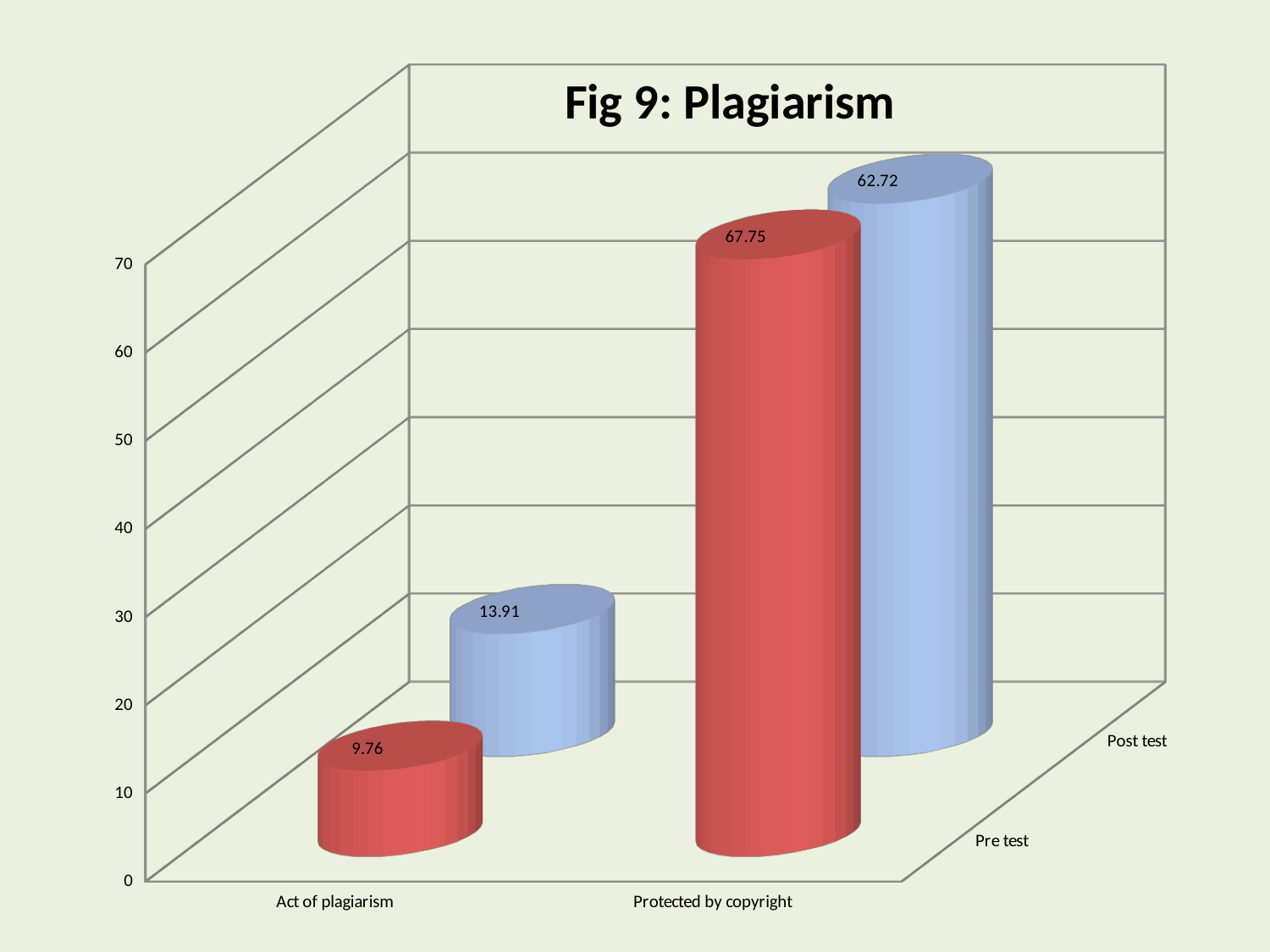
For Act of plagiarism, which is larger: the Pre test or the Post test value? Post test Which bar has the highest value on the chart? Protected by copyright, Pre test How many series (Pre test and Post test) are plotted on the chart? 2 What is the Pre test value for Protected by copyright? 67.75 What is the title of the chart? Fig 9: Plagiarism What is the difference between the Post test and Pre test values for Act of plagiarism? 4.15 What is the Pre test value for Act of plagiarism? 9.76 What is the Post test value for Act of plagiarism? 13.91 What is the difference between the Pre test and Post test values for Protected by copyright? 5.03 Which bar has the lowest value on the chart? Act of plagiarism, Pre test How many categories are shown on the horizontal axis? 2 What is the Post test value for Protected by copyright? 62.72